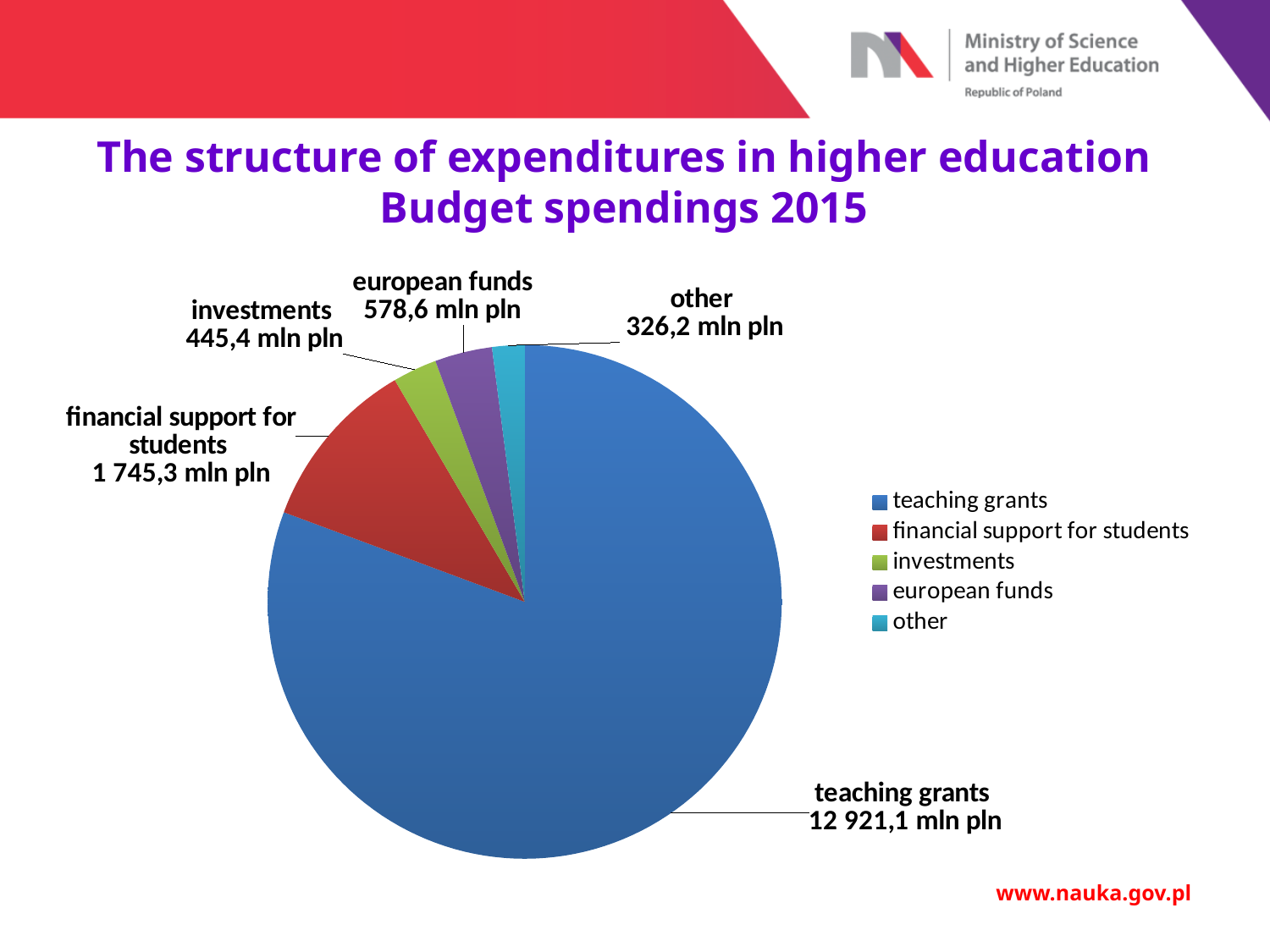
What is the value for financial support for students? 1 745,3 mln pln What is the value for investments? 445,4 mln pln What is the title of the slide? The structure of expenditures in higher education Budget spendings 2015 What is the value for teaching grants? 12 921,1 mln pln Which is larger, european funds or investments? european funds Which category has the smallest share of the pie? other What is the difference between european funds and investments? 133,2 mln pln What is the value for european funds? 578,6 mln pln What is the value for other? 326,2 mln pln How many categories does the pie chart have? 5 Which category has the largest share of the pie? teaching grants What kind of chart is shown on the slide? pie chart